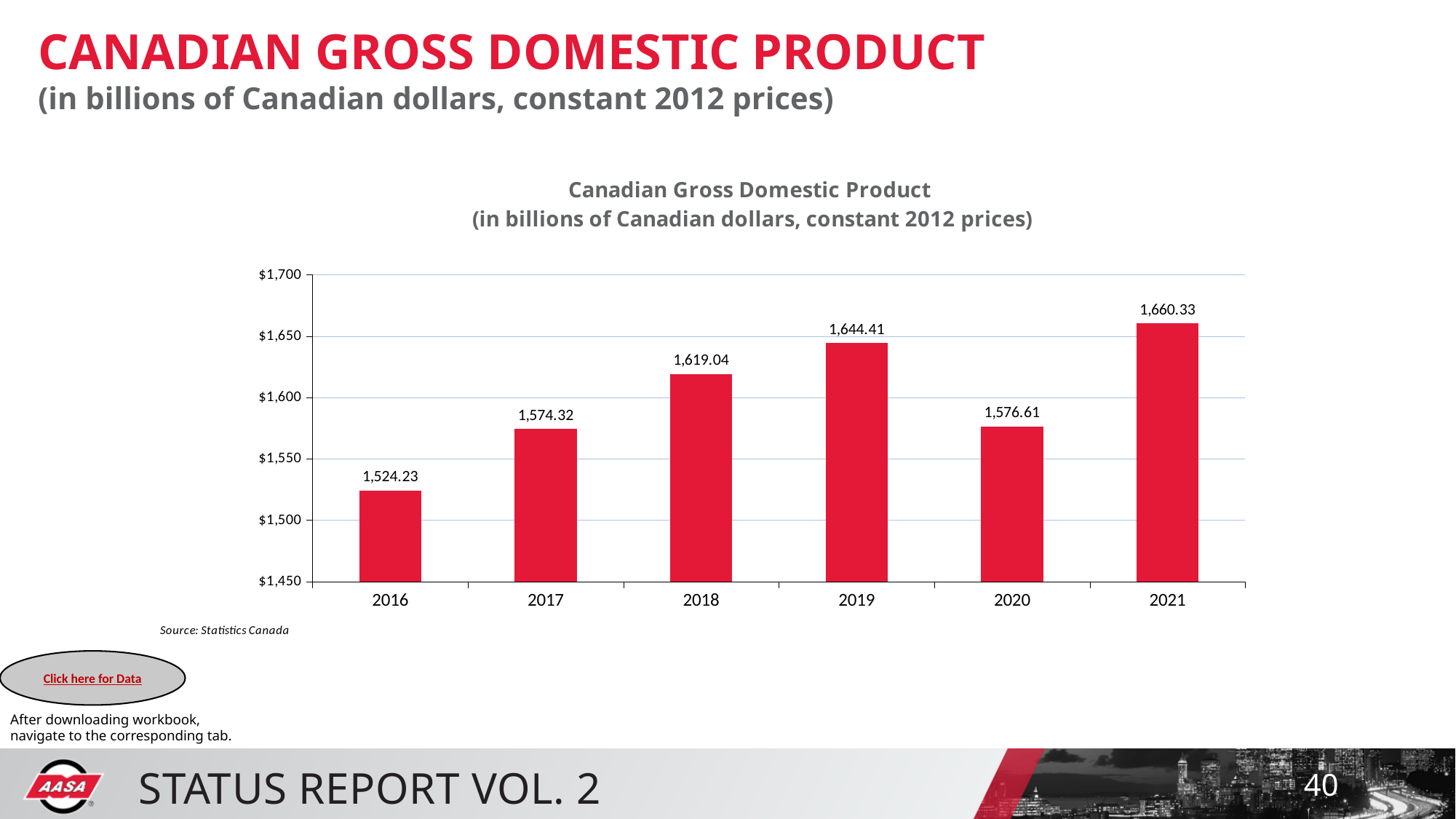
What is the value for 2019 in the Canadian Gross Domestic Product chart? 1,644.41 What is the difference between the 2021 and 2016 values in the Canadian Gross Domestic Product chart? 136.10 What kind of chart is used to show Canadian Gross Domestic Product? bar chart Which year has the highest value in the Canadian Gross Domestic Product chart? 2021 What is the value for 2020 in the Canadian Gross Domestic Product chart? 1,576.61 How many years are shown on the x axis of the Canadian Gross Domestic Product chart? 6 What is the difference between the 2019 and 2020 values in the Canadian Gross Domestic Product chart? 67.80 Which is larger in the Canadian Gross Domestic Product chart, the value for 2018 or the value for 2020? 2018 Is the value for 2017 in the Canadian Gross Domestic Product chart greater or less than $1,600? less Did the value in the Canadian Gross Domestic Product chart rise or fall from 2019 to 2020? fall What is the value for 2016 in the Canadian Gross Domestic Product chart? 1,524.23 Which year has the lowest value in the Canadian Gross Domestic Product chart? 2016